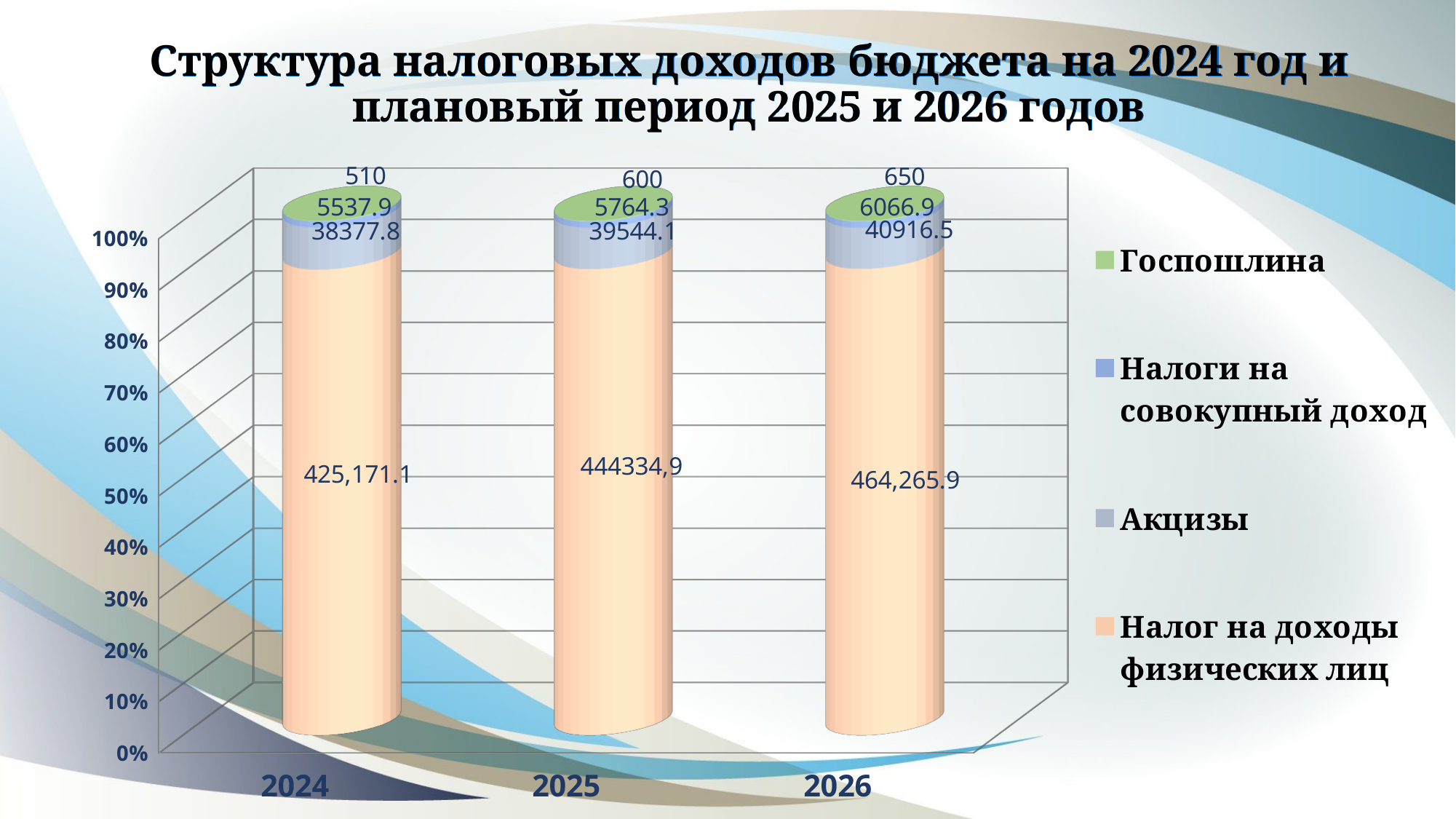
Which is larger: Акцизы for 2025 or Акцизы for 2026? 2026 Do the values of Налог на доходы физических лиц rise or fall from 2024 to 2026? rise What is the value of Акцизы for 2026? 40916.5 How many series does the legend list? 4 In which year is the value of Акцизы lowest? 2024 What is the value of Госпошлина for 2024? 510 How many years are shown on the x axis? 3 What is the difference between the Налоги на совокупный доход values for 2026 and 2025? 302.6 What is the difference between the Госпошлина values for 2026 and 2024? 140 What is the value of Налоги на совокупный доход for 2025? 5764.3 What is the value of Налог на доходы физических лиц for 2024? 425,171.1 In which year is the value of Госпошлина highest? 2026